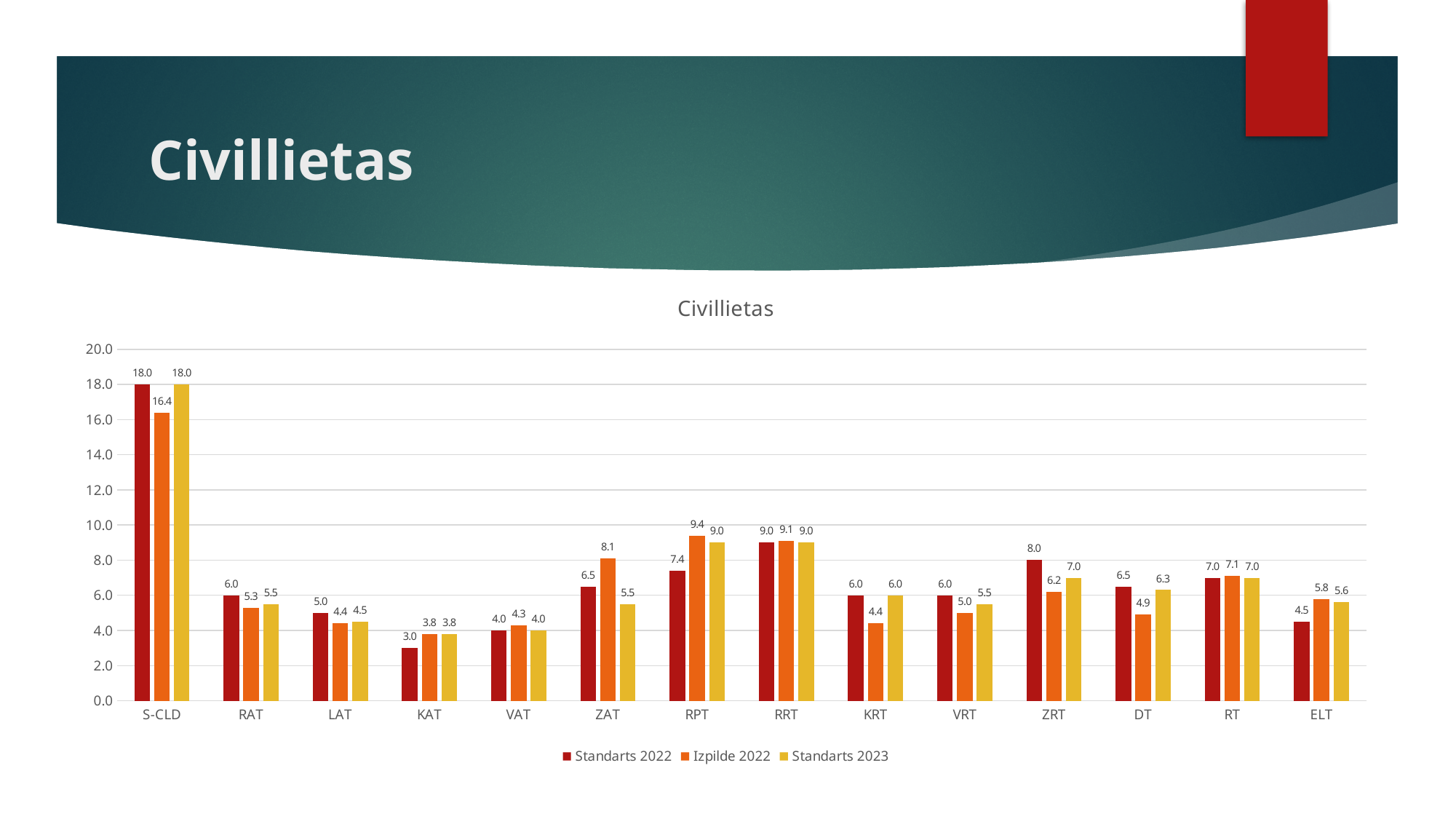
What is the title of the chart? Civillietas How many series does the legend list? 3 What is the Standarts 2022 value for RPT? 7.4 What is the Izpilde 2022 value for S-CLD? 16.4 How many categories are shown on the x axis? 14 Which category has the lowest Standarts 2022 value? KAT Which category has the highest Izpilde 2022 value? S-CLD What is the difference between the Izpilde 2022 and Standarts 2022 values for ZAT? 1.6 Which is larger for DT: the Standarts 2022 value or the Izpilde 2022 value? Standarts 2022 What is the Standarts 2023 value for ZRT? 7.0 What kind of chart is shown on the slide? Bar chart What is the Izpilde 2022 value for ELT? 5.8